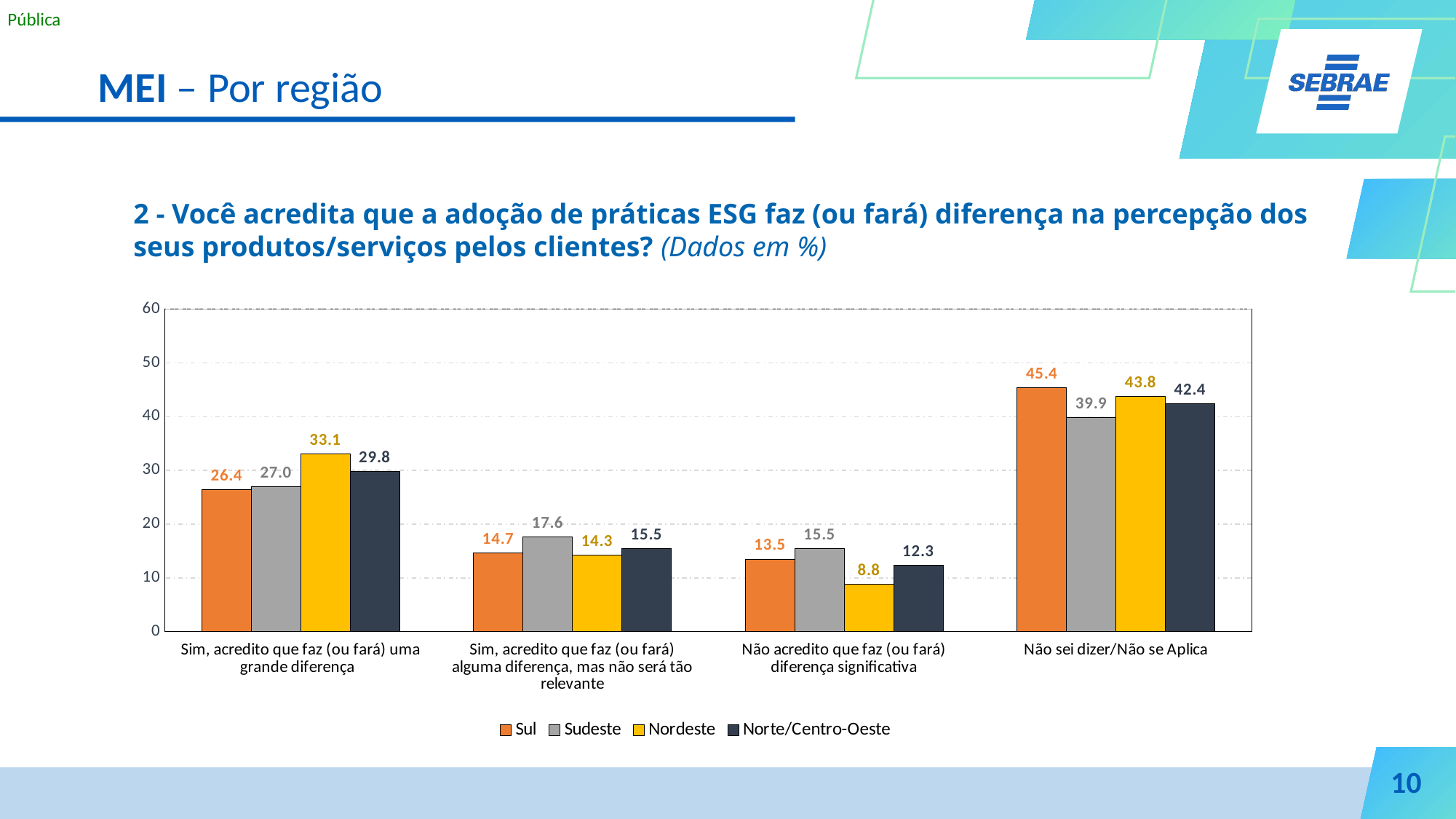
Is the value for Sudeste in the category "Não sei dizer/Não se Aplica" greater or less than 40? less What kind of chart is shown on the slide? Bar chart How many response categories are shown on the x axis? 4 What is the value for Norte/Centro-Oeste in the category "Não acredito que faz (ou fará) diferença significativa"? 12.3 What is the value for Nordeste in the category "Sim, acredito que faz (ou fará) uma grande diferença"? 33.1 Which is larger in the category "Sim, acredito que faz (ou fará) alguma diferença, mas não será tão relevante": Sudeste or Nordeste? Sudeste What is the difference between Sul and Sudeste in the category "Não sei dizer/Não se Aplica"? 5.5 What is the value for Sul in the category "Não sei dizer/Não se Aplica"? 45.4 How many series does the legend list? 4 Which region has the highest value in the category "Sim, acredito que faz (ou fará) uma grande diferença"? Nordeste Which region has the lowest value in the category "Não acredito que faz (ou fará) diferença significativa"? Nordeste Which colour represents the Nordeste series in the legend? Yellow